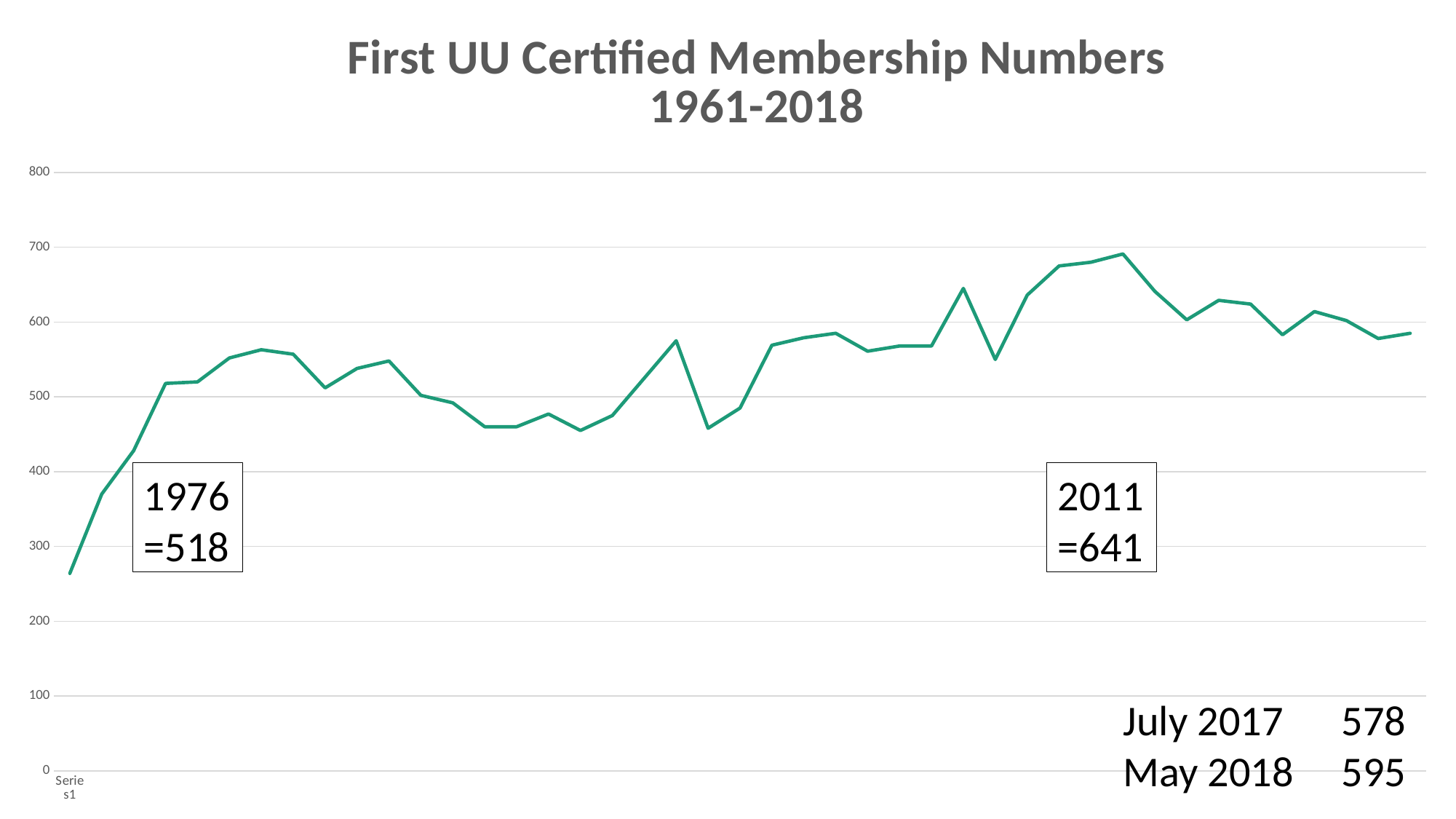
By how much does the May 2018 membership number exceed the July 2017 number? 17 What is the difference between the annotated 2011 membership number and the annotated 1976 membership number? 123 Which is larger, the membership number for May 2018 or for July 2017? May 2018 What membership number is annotated for 1976? 518 What membership number is given for May 2018? 595 Is the highest point on the line greater or less than 650? greater What kind of chart is shown on the slide? line chart What is the title of the chart? First UU Certified Membership Numbers 1961-2018 What membership number is given for July 2017? 578 What membership number is annotated for 2011? 641 Is the first plotted value at the left of the line greater or less than 300? less Overall, do the membership numbers rise or fall from the left of the chart to the right? rise